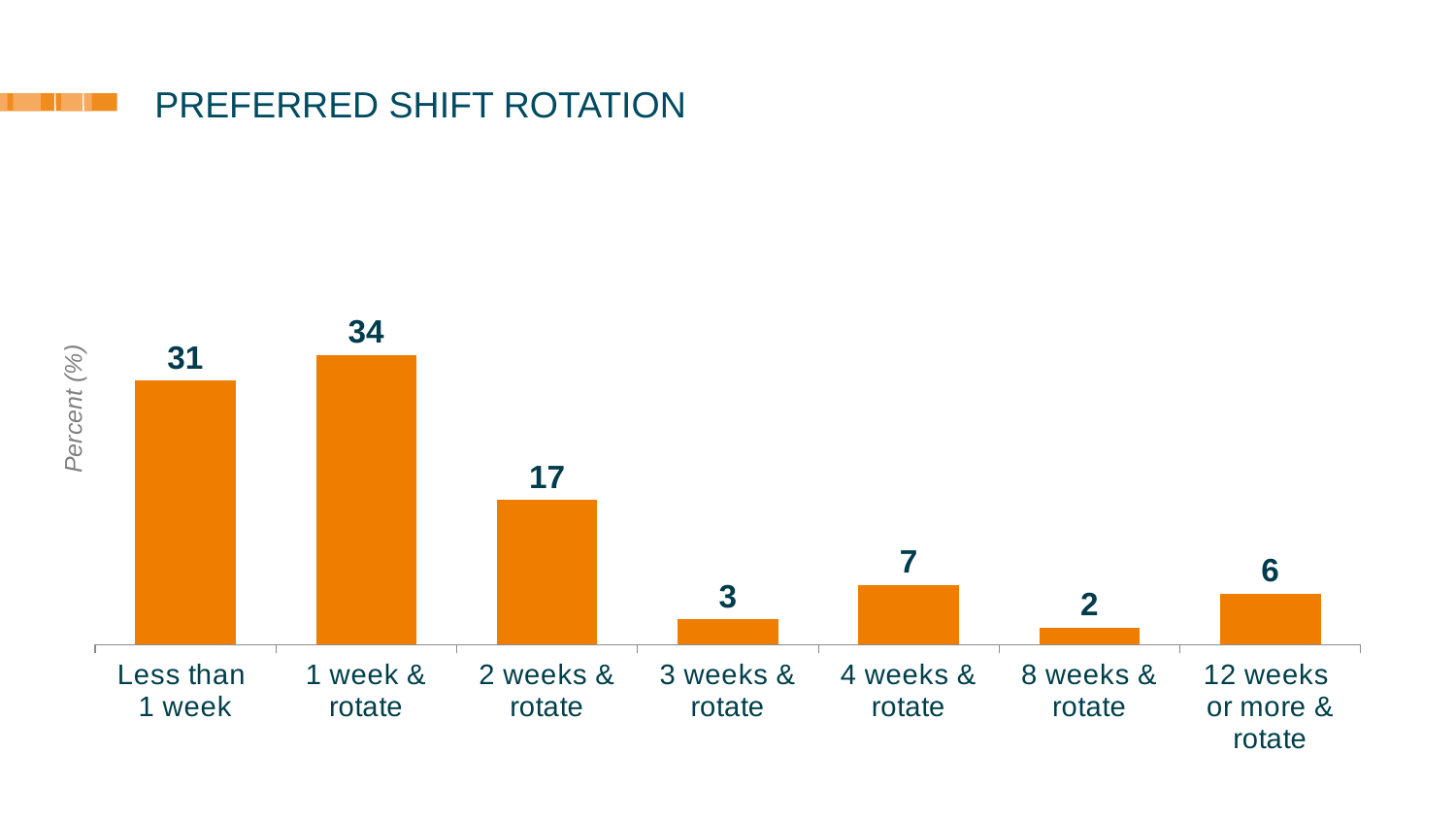
What is the title of the slide? PREFERRED SHIFT ROTATION What is the label on the vertical axis? Percent (%) Which is larger, the value for "4 weeks & rotate" or the value for "3 weeks & rotate"? 4 weeks & rotate What is the value for "8 weeks & rotate"? 2 How many categories are shown on the x axis? 7 What is the value for "1 week & rotate"? 34 What kind of chart is shown on the slide? Bar chart Which category has the highest value? 1 week & rotate What is the value for "Less than 1 week"? 31 Which category has the lowest value? 8 weeks & rotate What is the difference between the values for "1 week & rotate" and "2 weeks & rotate"? 17 What is the value for "12 weeks or more & rotate"? 6